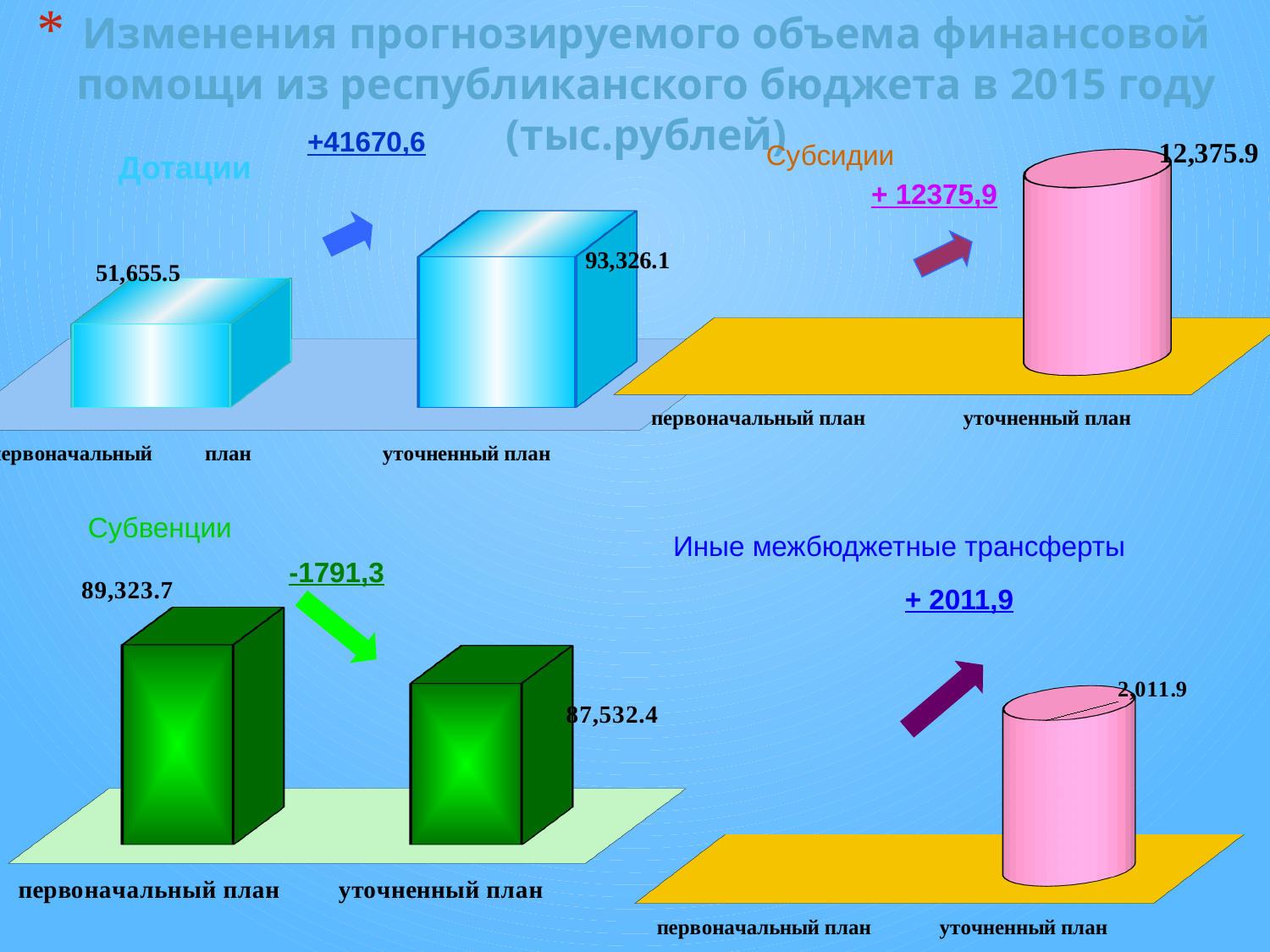
In the Дотации chart, what is the change shown between первоначальный план and уточненный план? +41670,6 In the Субсидии chart, what is the value for уточненный план? 12,375.9 In the Субвенции chart, what is the value for первоначальный план? 89,323.7 In the Дотации chart, what is the value for первоначальный план? 51,655.5 In the Субвенции chart, which category has the lower value? уточненный план In the Субвенции chart, do the values rise or fall from первоначальный план to уточненный план? fall In the Субвенции chart, what is the value for уточненный план? 87,532.4 What kind of chart is the Субвенции chart? bar chart In the Дотации chart, which category has the higher value, первоначальный план or уточненный план? уточненный план How many categories are shown on the x axis of the Субвенции chart? 2 In the Иные межбюджетные трансферты chart, what is the value for уточненный план? 2,011.9 In the Дотации chart, what is the value for уточненный план? 93,326.1